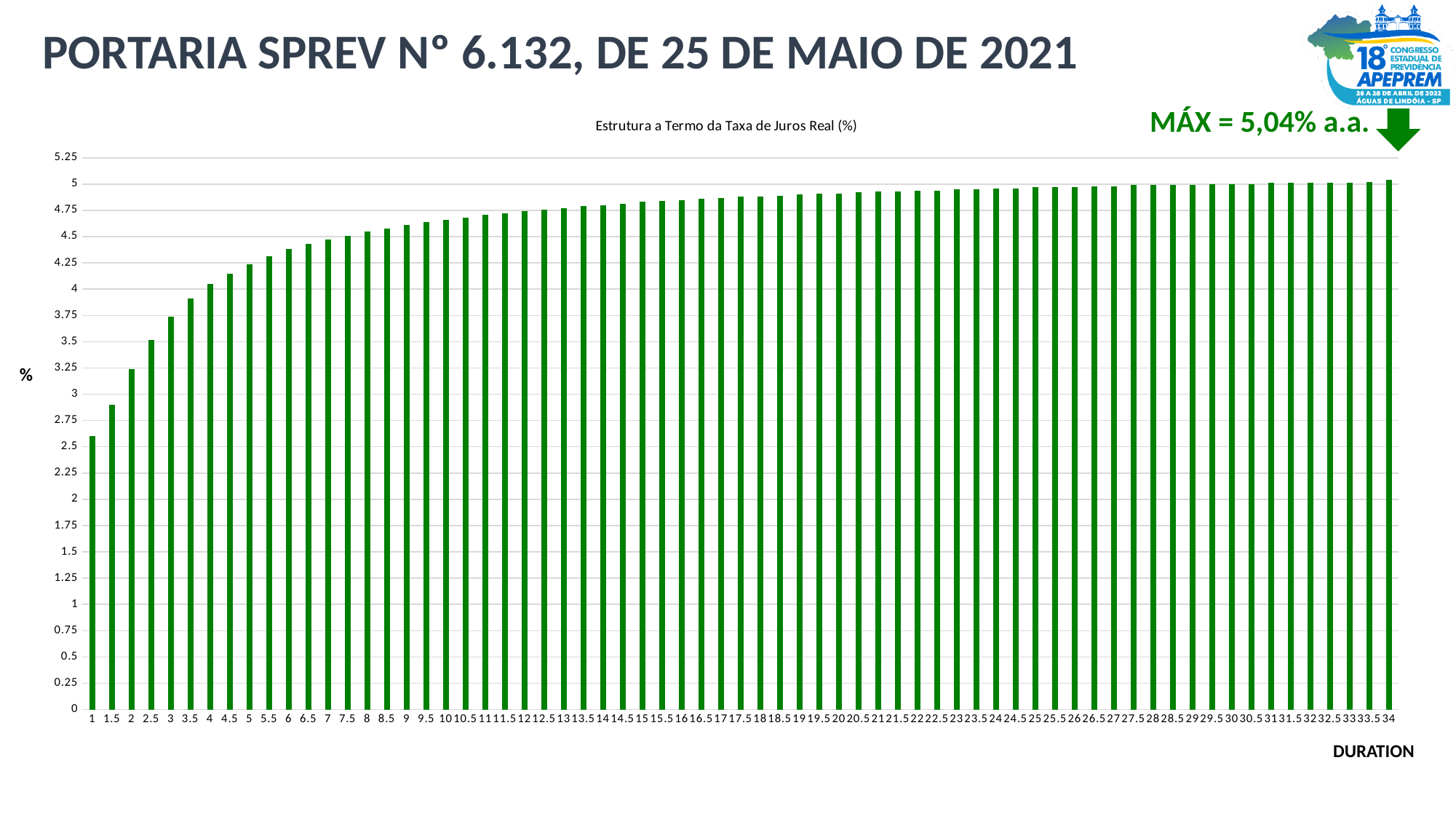
What is the title of the chart? Estrutura a Termo da Taxa de Juros Real (%) Is the value for duration 3 greater or less than 4? less Which is larger, the value for duration 5 or the value for duration 20? duration 20 What maximum value is annotated on the slide? 5,04% a.a. Which duration has the highest value? 34 Is the value for duration 10 greater or less than 4.5? greater Do the values rise or fall as duration increases along the x axis? rise What kind of chart is shown on the slide? bar chart Is the value for duration 1 greater or less than 3? less Which duration has the lowest value? 1 How many bars are plotted in the chart? 67